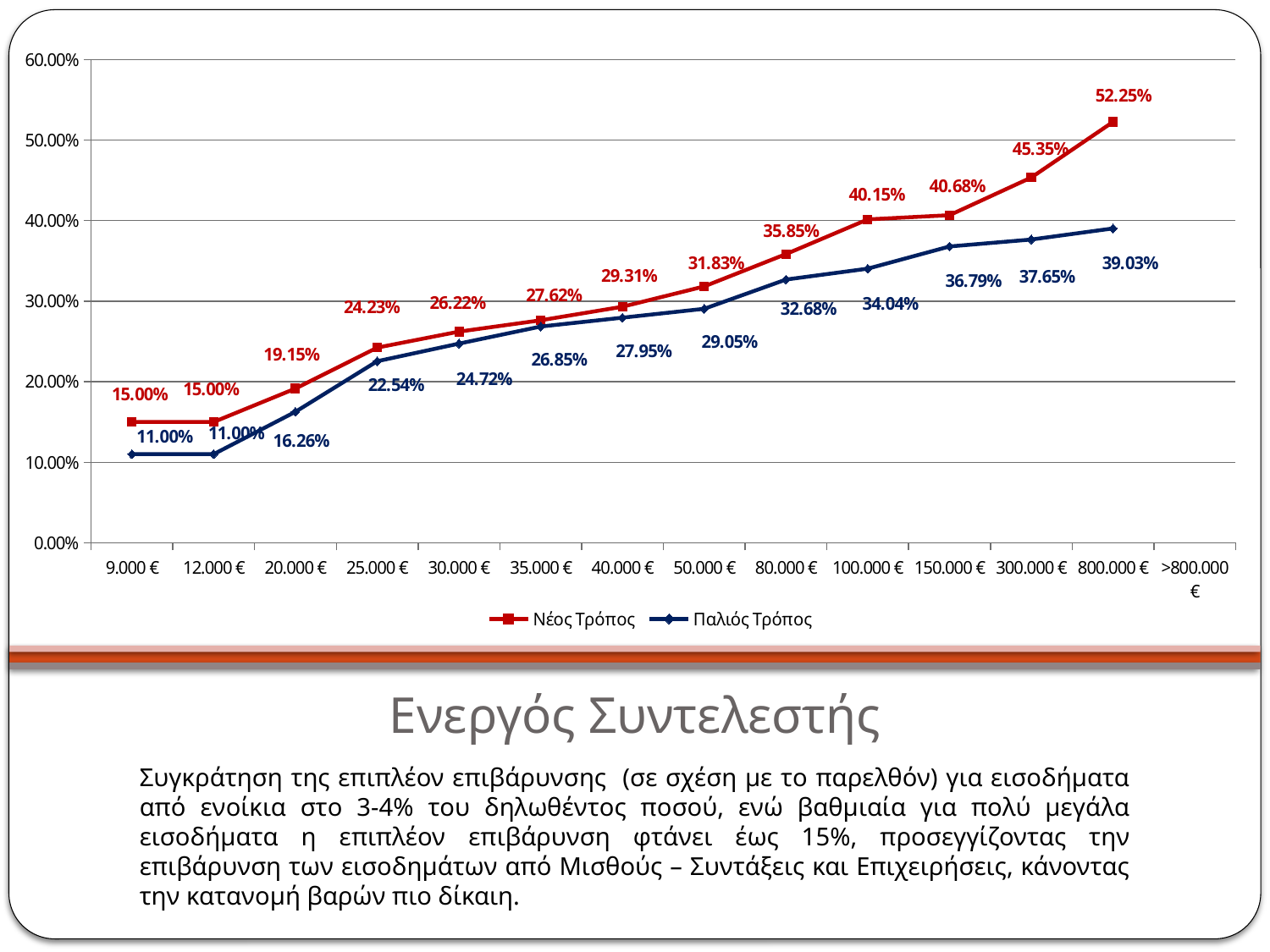
What colour is the Νέος Τρόπος line? Red What is the highest value plotted for Νέος Τρόπος? 52.25% What is the value of Νέος Τρόπος at 25.000 €? 24.23% What is the value of Νέος Τρόπος at 9.000 €? 15.00% At 20.000 €, what is the difference between Νέος Τρόπος and Παλιός Τρόπος? 2.89% What is the lowest value plotted for Παλιός Τρόπος? 11.00% What is the highest value plotted for Παλιός Τρόπος? 39.03% At 25.000 €, which series has the higher value, Νέος Τρόπος or Παλιός Τρόπος? Νέος Τρόπος How many series does the legend list? 2 What kind of chart is shown on the slide? Line chart Do the values of Νέος Τρόπος rise or fall as income increases along the x axis? Rise What is the value of Παλιός Τρόπος at 20.000 €? 16.26%